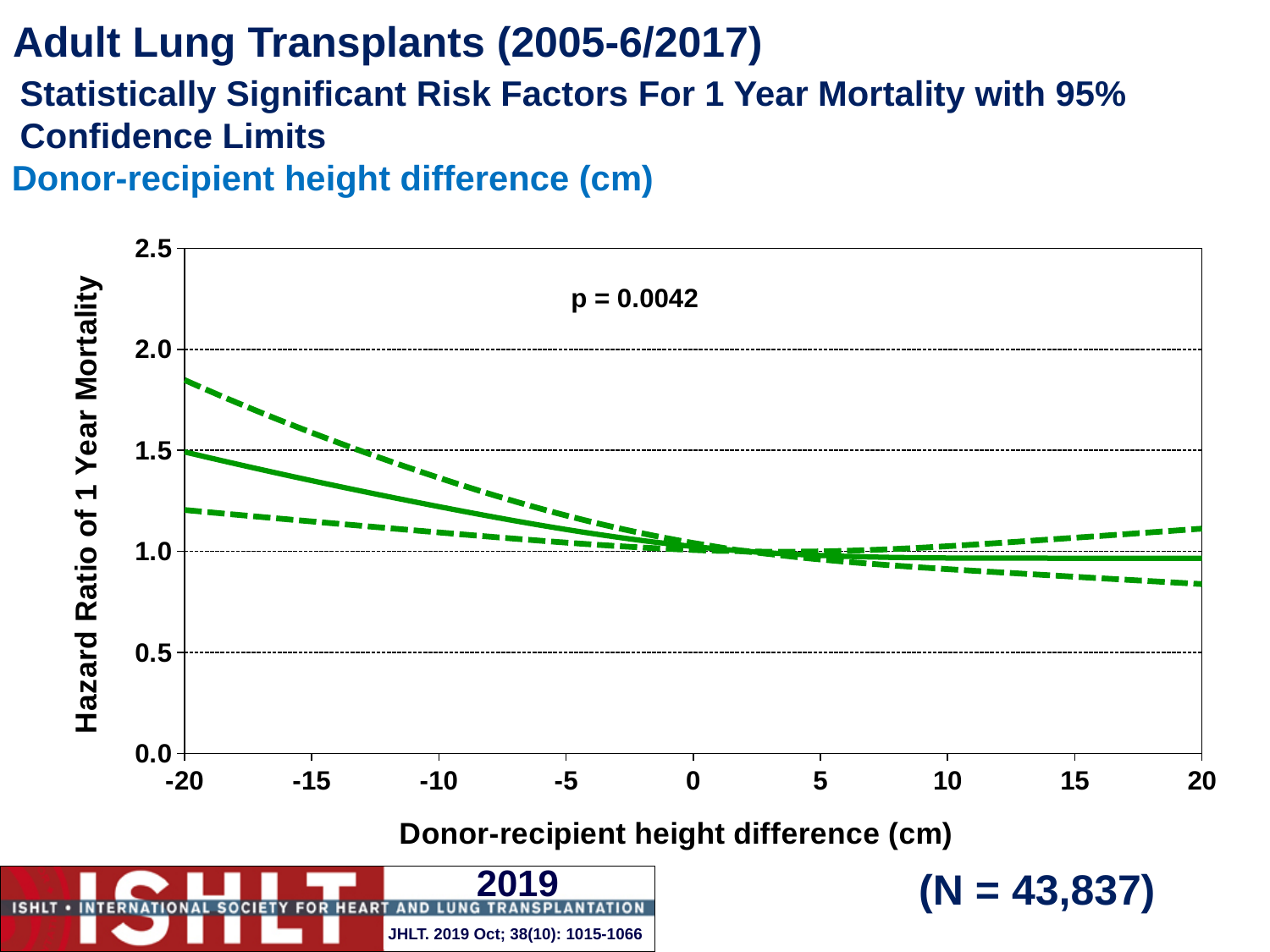
Is the hazard ratio on the solid line larger at a height difference of -20 cm or at 20 cm? -20 cm At which donor-recipient height difference is the solid hazard ratio line highest? -20 How many lines are plotted on the chart? 3 Is the upper dashed confidence limit at a height difference of -20 cm greater or less than 1.5? greater What kind of chart is shown on the slide? line chart What sample size (N) is shown on the slide? N = 43,837 What p-value is printed on the chart? p = 0.0042 Is the lower dashed confidence limit at a height difference of 20 cm greater or less than 1.0? less Is the upper dashed confidence limit at a height difference of 20 cm greater or less than 1.5? less Does the solid hazard ratio line rise or fall as the donor-recipient height difference increases from -20 to 20 cm? fall